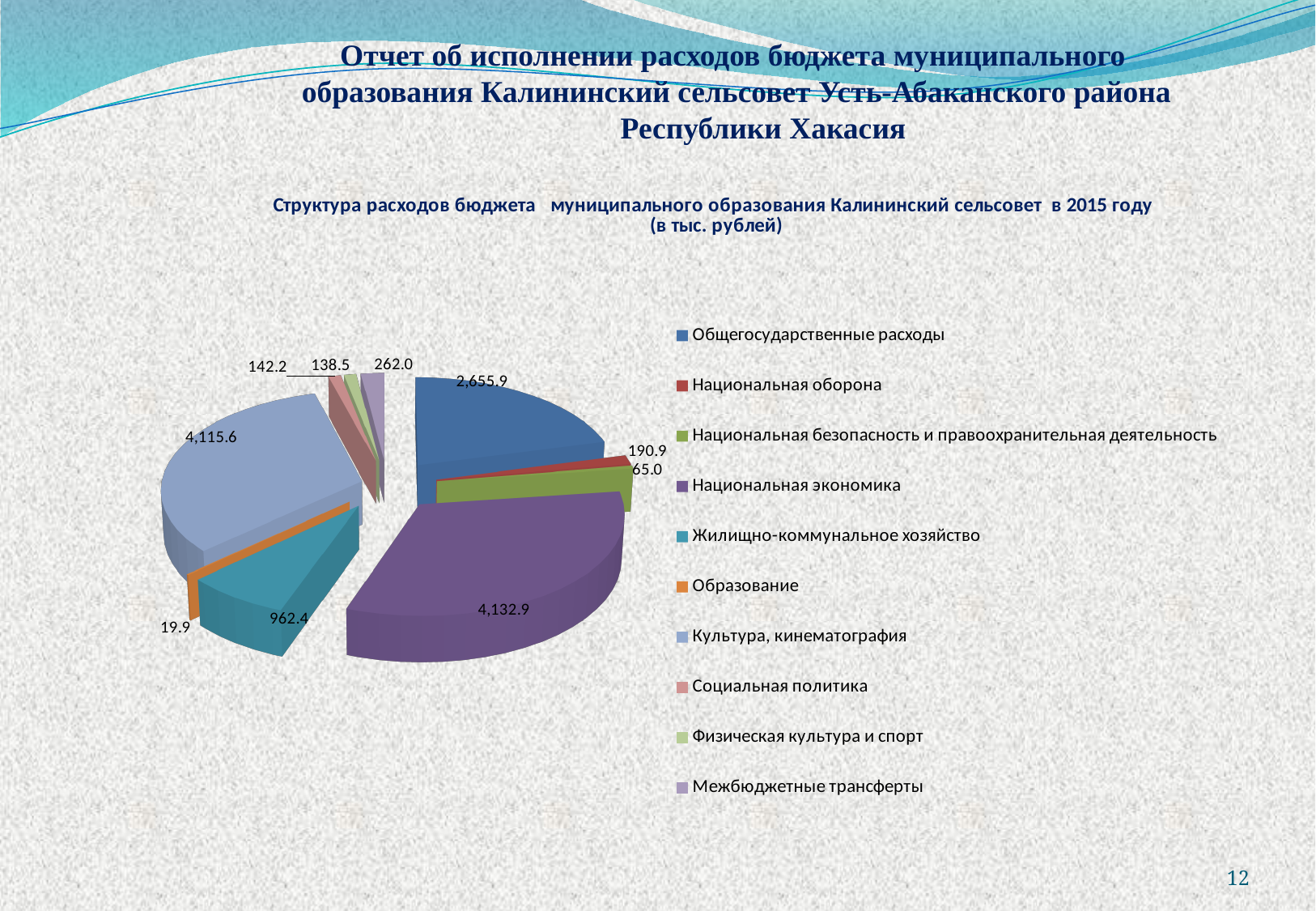
What is the value for Межбюджетные трансферты? 262.0 What is the value for Культура, кинематография? 4,115.6 In what units are the values in the chart given, according to its title? тыс. рублей What is the value for Образование? 19.9 Which is larger, Общегосударственные расходы or Жилищно-коммунальное хозяйство? Общегосударственные расходы What kind of chart is shown on the slide? Pie chart How many categories does the pie chart show? 10 What is the value for Жилищно-коммунальное хозяйство? 962.4 Which category has the largest value? Национальная экономика What is the value for Национальная экономика? 4,132.9 What is the difference between Национальная экономика and Культура, кинематография? 17.3 Which category has the smallest value? Образование